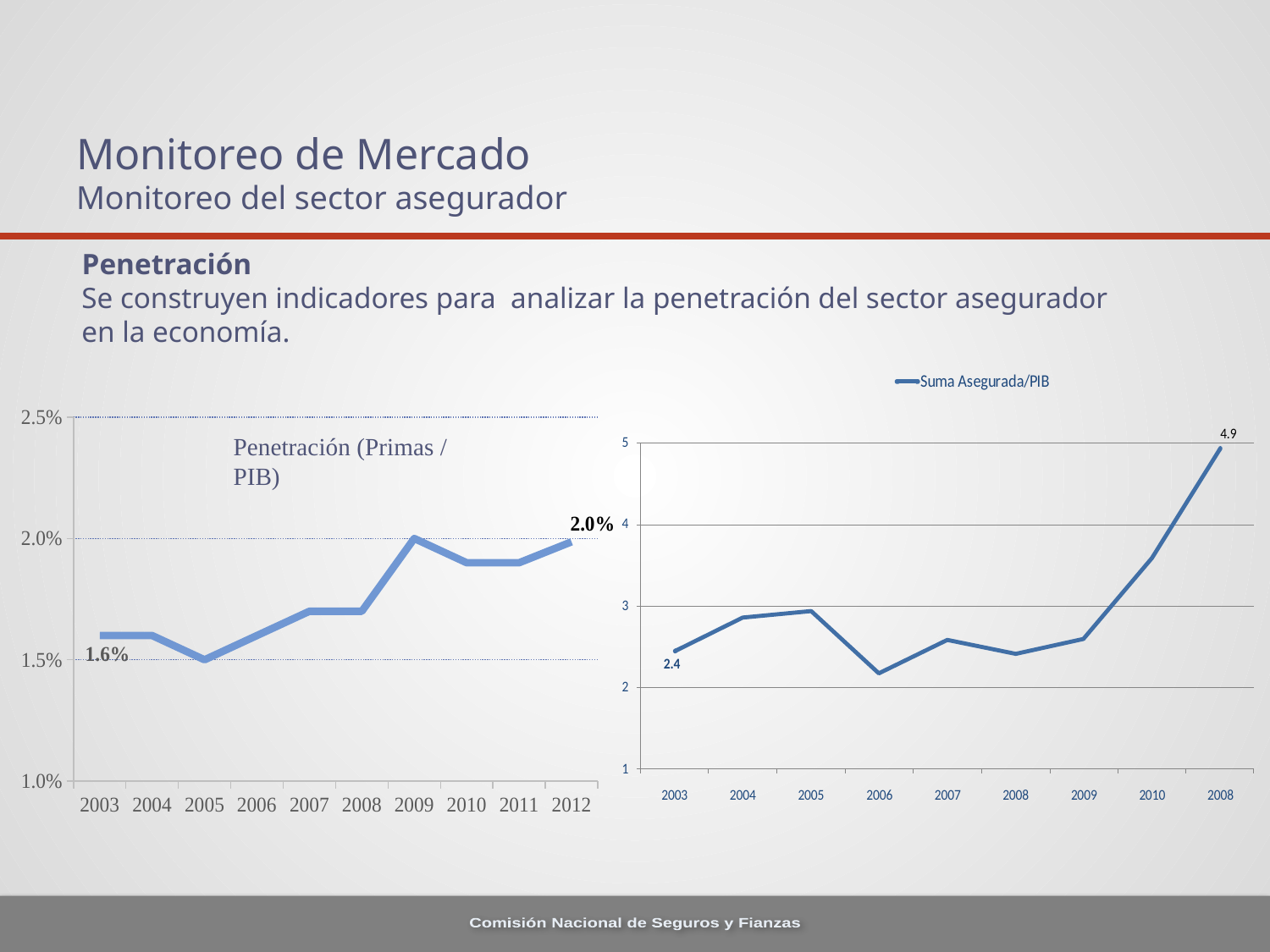
On the left chart (Penetración (Primas / PIB)), what is the difference between the 2012 value and the 2003 value? 0.4% On the right chart (Suma Asegurada/PIB), what is the value for 2003? 2.4 On the right chart (Suma Asegurada/PIB), is the value for 2010 greater or less than 3? greater On the left chart (Penetración (Primas / PIB)), which year has the lowest value? 2005 On the left chart (Penetración (Primas / PIB)), what is the value for 2012? 2.0% On the left chart (Penetración (Primas / PIB)), what is the value for 2003? 1.6% On the left chart (Penetración (Primas / PIB)), is the value for 2005 greater or less than 2.0%? less On the right chart (Suma Asegurada/PIB), which year has the lowest value? 2006 What kind of chart is the left chart (Penetración (Primas / PIB))? line chart On the right chart (Suma Asegurada/PIB), what is the difference between the final point's value and the 2003 value? 2.5 On the left chart (Penetración (Primas / PIB)), how many years are plotted on the x axis? 10 On the right chart (Suma Asegurada/PIB), what is the value at the final (rightmost) point? 4.9